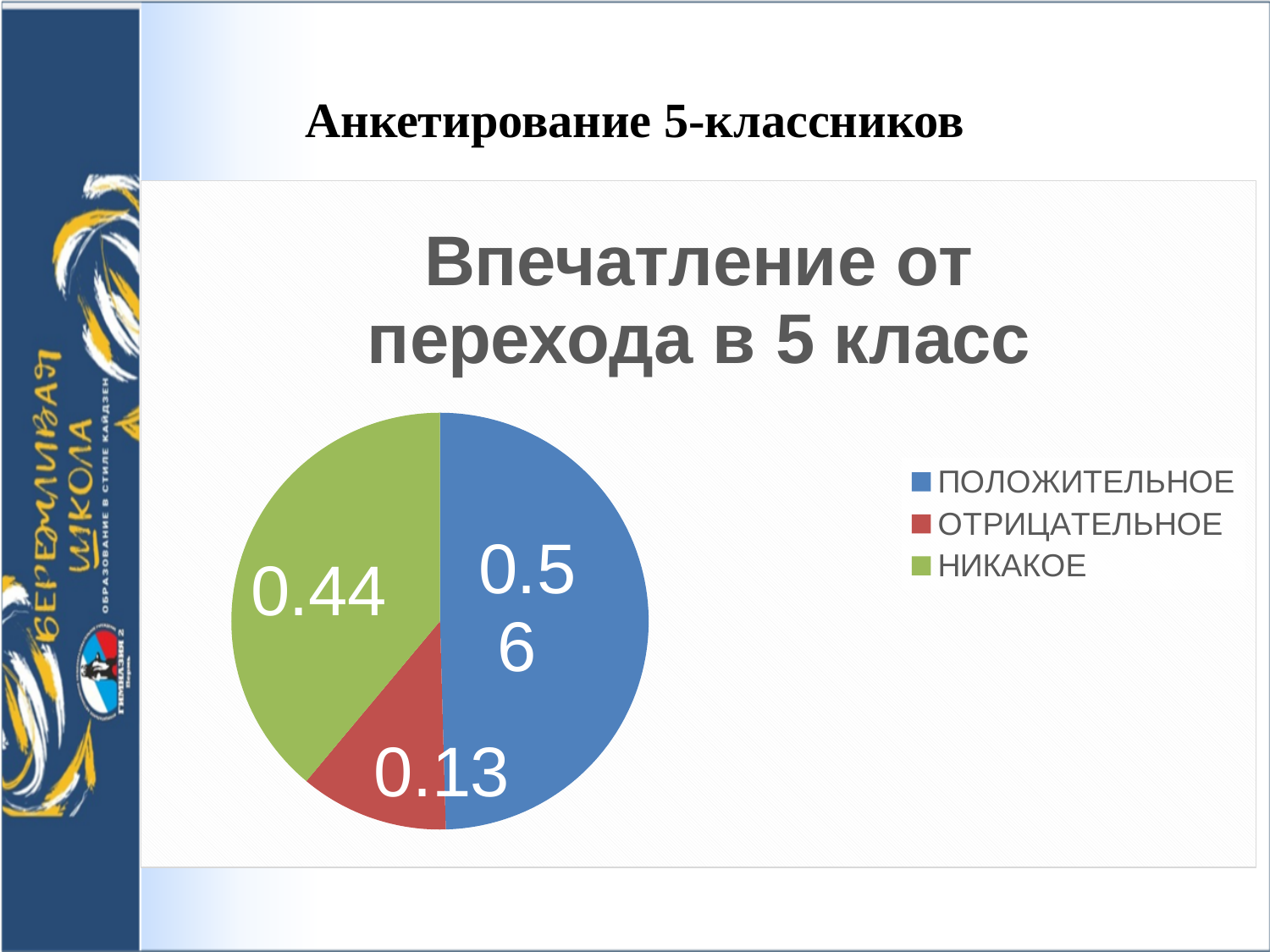
How many entries does the legend list? 3 What is the difference between the values for НИКАКОЕ and ОТРИЦАТЕЛЬНОЕ? 0.31 What value is shown for the ПОЛОЖИТЕЛЬНОЕ slice? 0.56 Which category has the largest slice of the pie? ПОЛОЖИТЕЛЬНОЕ What type of chart is shown on the slide? pie chart What is the title of the chart? Впечатление от перехода в 5 класс Which is larger, the НИКАКОЕ slice or the ОТРИЦАТЕЛЬНОЕ slice? НИКАКОЕ What colour is the НИКАКОЕ slice? green Which category has the smallest slice of the pie? ОТРИЦАТЕЛЬНОЕ What value is shown for the ОТРИЦАТЕЛЬНОЕ slice? 0.13 How many slices does the pie chart have? 3 What value is shown for the НИКАКОЕ slice? 0.44